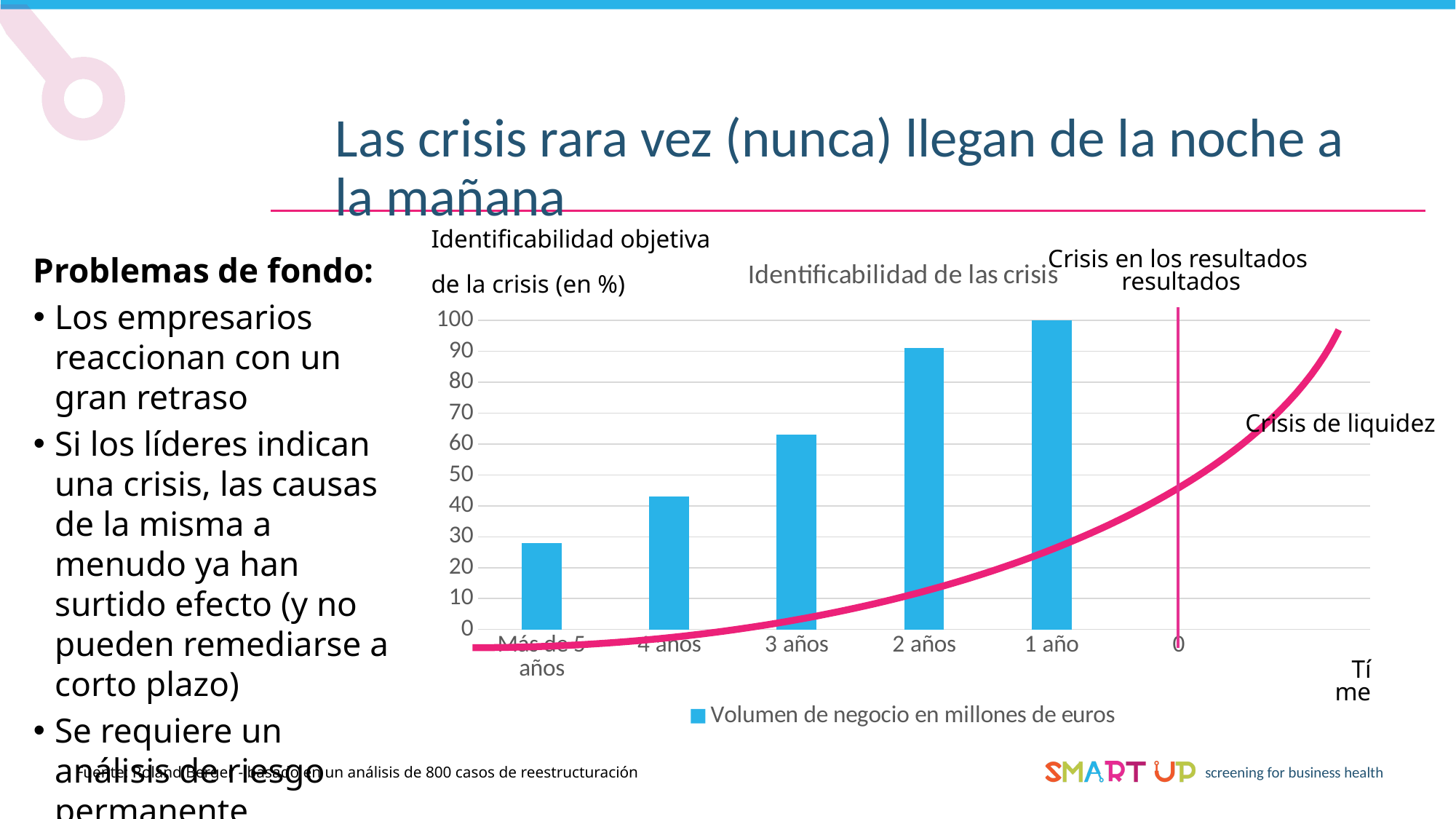
What is the title of the chart? Identificabilidad de las crisis Which category has the lowest bar among the plotted bars? Más de 5 años Which category has the highest bar in the chart? 1 año Is the value for Más de 5 años greater or less than 30? less Is the value for 3 años greater or less than 60? greater Is the value for 2 años greater or less than 80? greater Which is larger, the bar for 2 años or the bar for 3 años? 2 años What kind of chart is shown on the slide? bar chart What is the value of the bar for 1 año? 100 What is the legend entry for the bars in the chart? Volumen de negocio en millones de euros Do the bar values rise or fall from Más de 5 años to 1 año? rise How many series does the chart legend list? 1